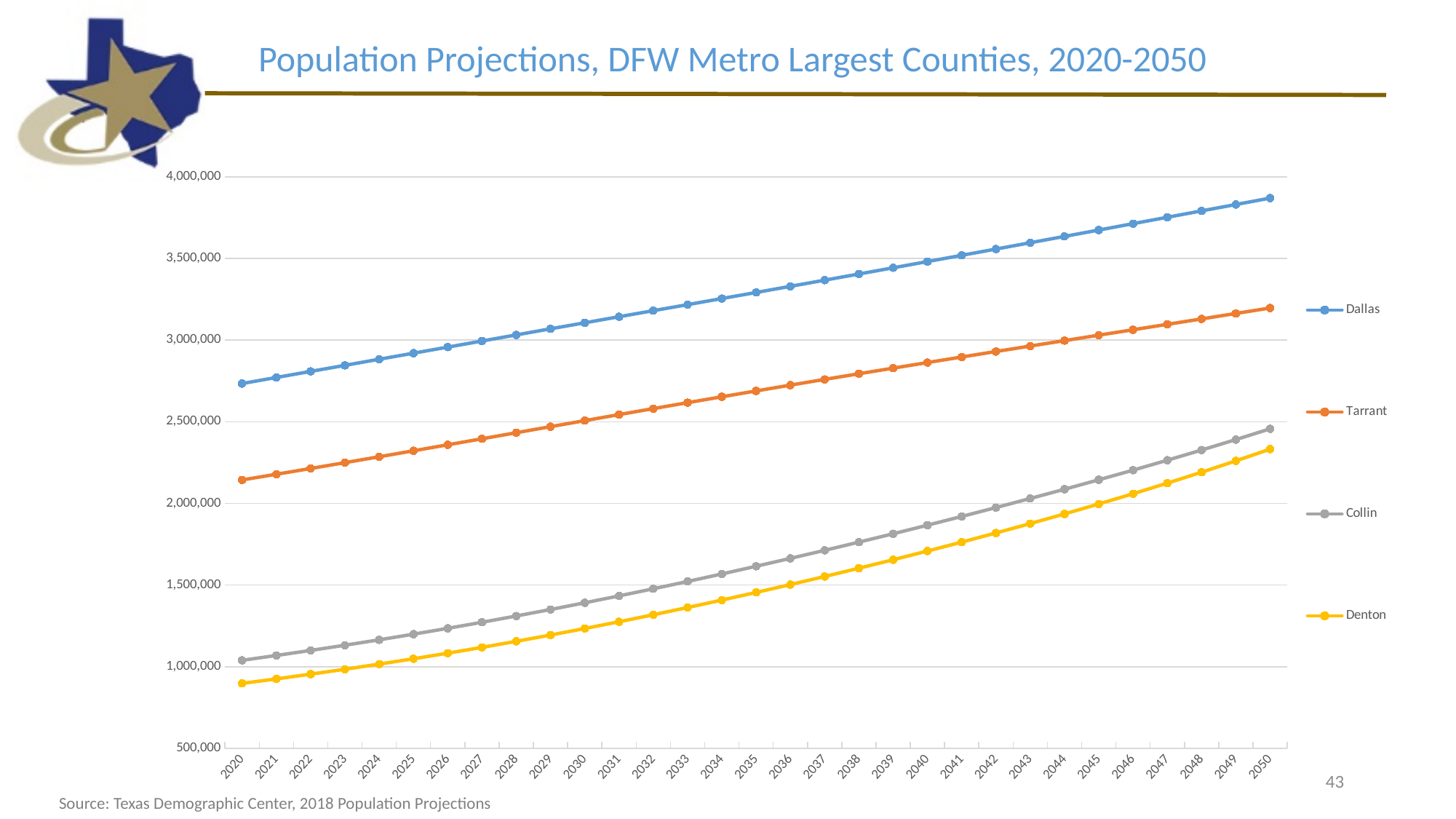
Which county has the highest projected population in 2050? Dallas Is the value for Denton in 2020 greater or less than 1,000,000? less What is the title of the chart? Population Projections, DFW Metro Largest Counties, 2020-2050 Is the value for Dallas in 2050 greater or less than 4,000,000? less Is the value for Tarrant in 2050 greater or less than 3,000,000? greater What kind of chart is shown on the slide? Line chart Which county has the lowest projected population in 2020? Denton Do the projected populations rise or fall from 2020 to 2050? Rise How many years are plotted along the x axis? 31 How many series does the legend list? 4 Which is larger in 2050, the value for Collin or the value for Denton? Collin